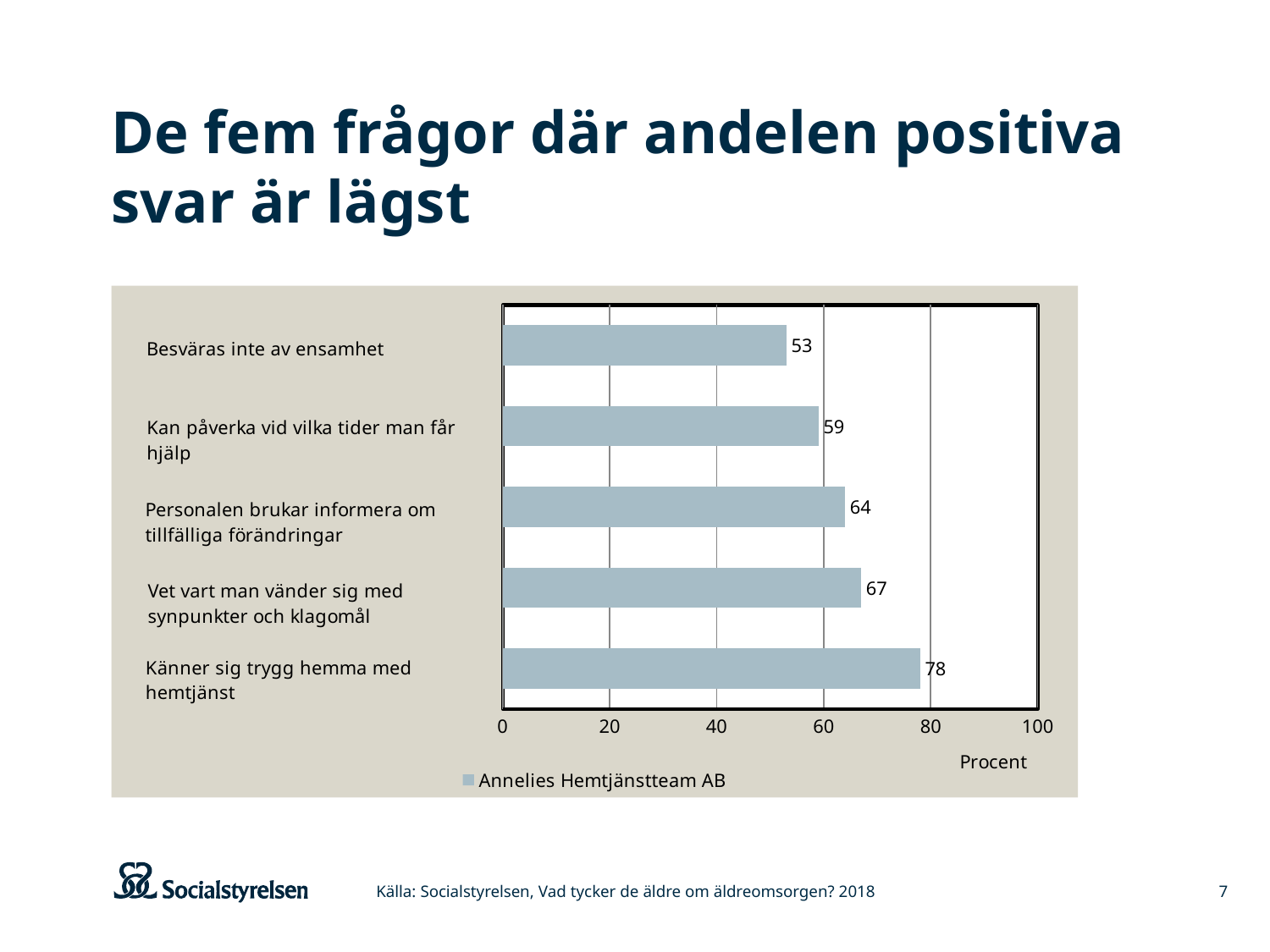
What is the value for "Besväras inte av ensamhet"? 53 What is the value for "Känner sig trygg hemma med hemtjänst"? 78 What is the difference between the values for "Känner sig trygg hemma med hemtjänst" and "Besväras inte av ensamhet"? 25 Which is larger: the value for "Vet vart man vänder sig med synpunkter och klagomål" or for "Kan påverka vid vilka tider man får hjälp"? Vet vart man vänder sig med synpunkter och klagomål What series name is shown in the legend? Annelies Hemtjänstteam AB What kind of chart is shown on the slide? bar chart How many series does the legend list? 1 Which category has the lowest value? Besväras inte av ensamhet Is the value for "Kan påverka vid vilka tider man får hjälp" greater or less than 60? less Which category has the highest value? Känner sig trygg hemma med hemtjänst How many categories are shown in the chart? 5 What is the value for "Personalen brukar informera om tillfälliga förändringar"? 64